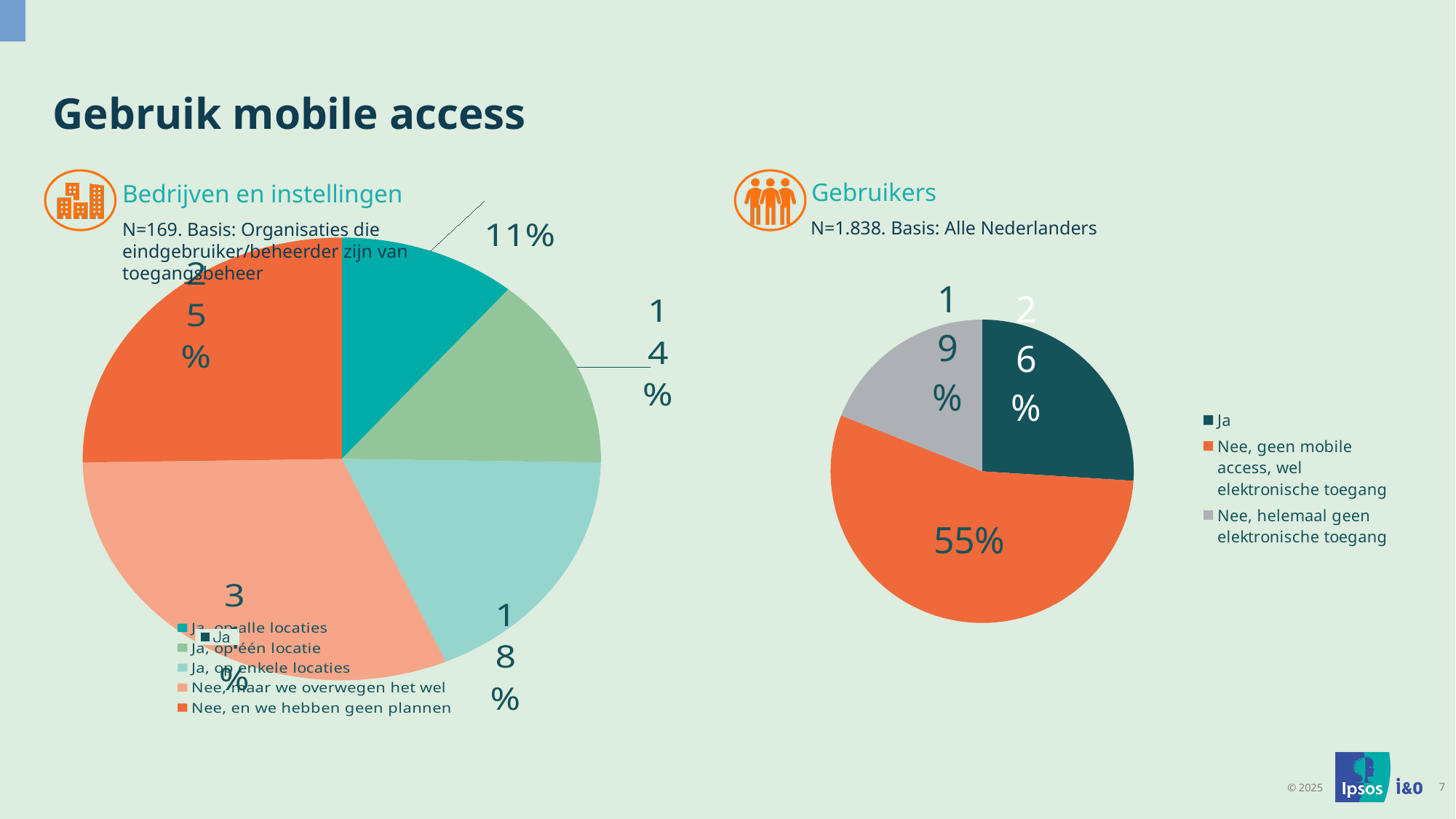
What type of chart is used for 'Bedrijven en instellingen'? Pie chart How many categories does the legend of the 'Gebruikers' pie chart list? 3 In the 'Gebruikers' pie chart, what percentage is shown for 'Nee, geen mobile access, wel elektronische toegang'? 55% In the 'Gebruikers' pie chart, what is the difference in percentage points between 'Nee, geen mobile access, wel elektronische toegang' and 'Ja'? 29 In the 'Gebruikers' pie chart, what percentage is shown for 'Ja'? 26% In the 'Gebruikers' pie chart, which category has the smallest share? Nee, helemaal geen elektronische toegang In the 'Bedrijven en instellingen' pie chart, which is larger: 'Ja, op enkele locaties' or 'Ja, op één locatie'? Ja, op enkele locaties What is the sample size (N) stated for the 'Gebruikers' chart? N=1.838 In the 'Gebruikers' pie chart, what percentage is shown for 'Nee, helemaal geen elektronische toegang'? 19% In the 'Gebruikers' pie chart, which category has the largest share? Nee, geen mobile access, wel elektronische toegang In the 'Bedrijven en instellingen' pie chart, what percentage is shown for 'Ja, op alle locaties'? 11%